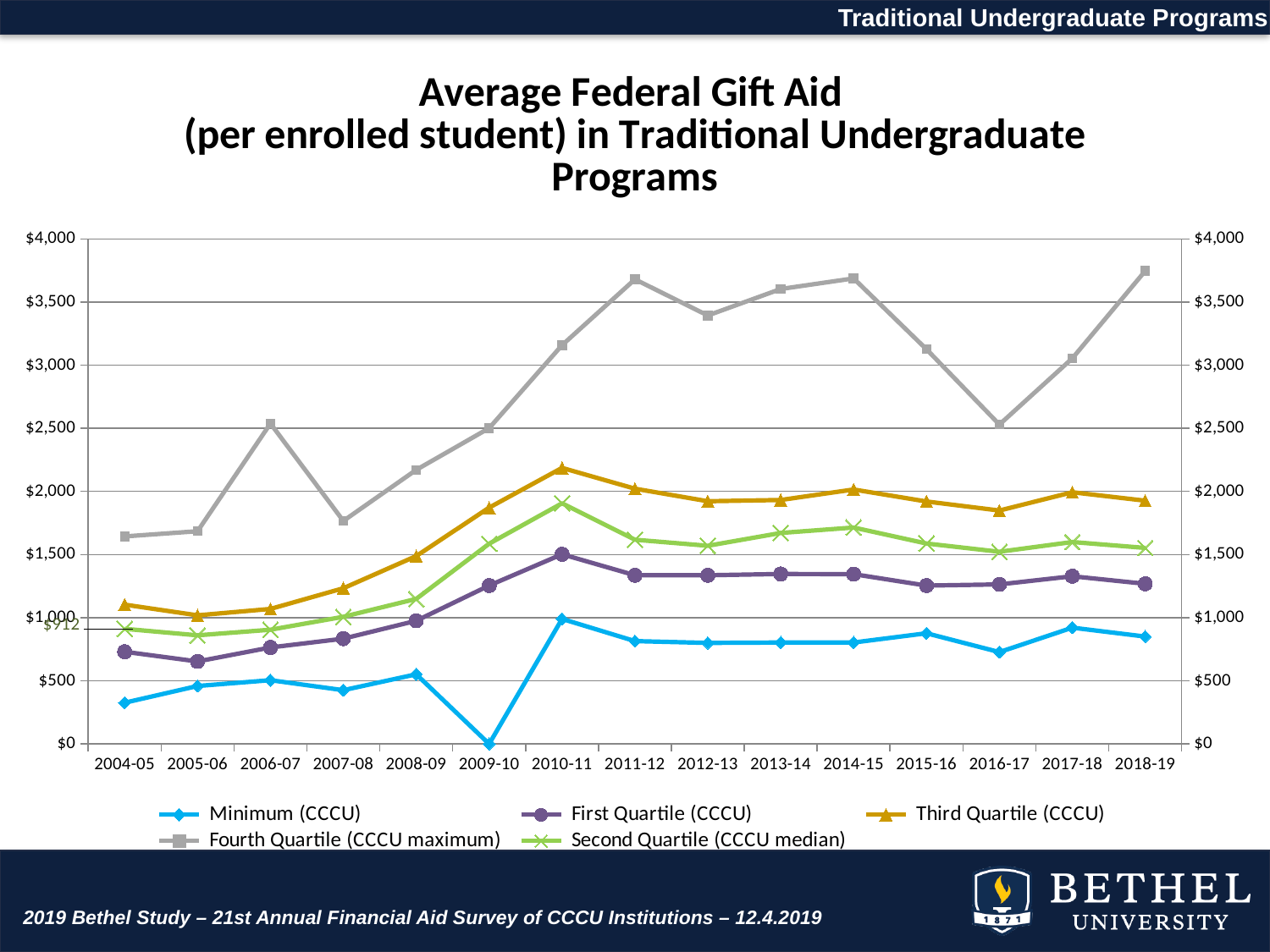
What kind of chart is shown on the slide? line chart How many series does the legend list? 5 Is the Third Quartile (CCCU) value for 2010-11 greater or less than $2,000? greater What is the title of the chart? Average Federal Gift Aid (per enrolled student) in Traditional Undergraduate Programs Is the Second Quartile (CCCU median) value for 2010-11 greater or less than $1,500? greater In which year is the Minimum (CCCU) series at its lowest? 2009-10 Which series in the legend is drawn with triangle markers? Third Quartile (CCCU) Does the Fourth Quartile (CCCU maximum) series rise or fall from 2007-08 to 2010-11? rise Is the Third Quartile (CCCU) value for 2016-17 greater or less than $2,000? less How many academic years are plotted along the x axis? 15 For the Fourth Quartile (CCCU maximum) series, which year has the larger value: 2006-07 or 2007-08? 2006-07